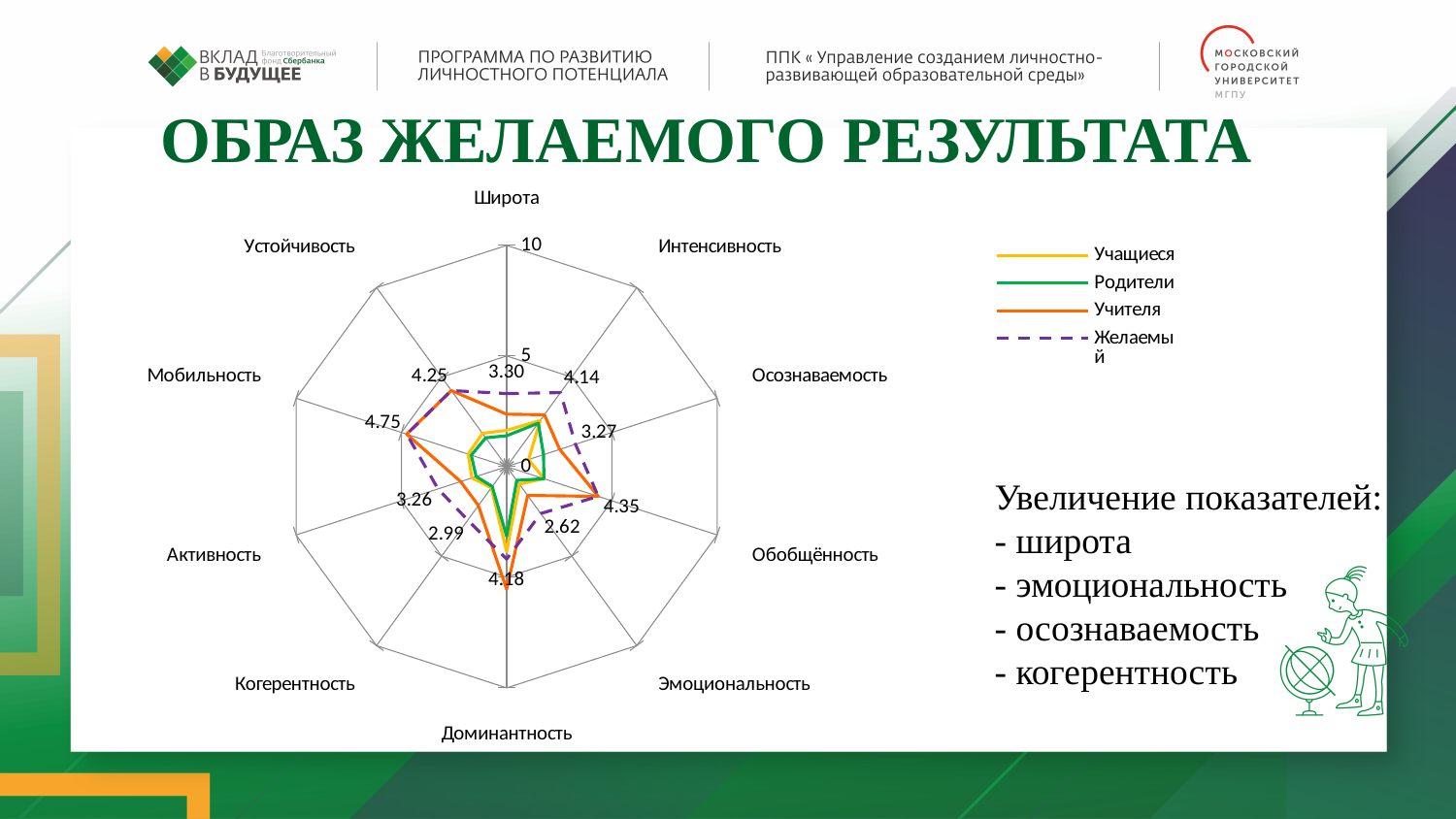
What kind of chart is shown on the slide? radar chart What value is labelled on the Широта axis of the chart? 3.30 Which labelled value is larger: Обобщённость or Осознаваемость? Обобщённость Which axis has the highest labelled value on the chart? Мобильность Which series in the legend is drawn with a dashed line? Желаемый What value is labelled on the Мобильность axis of the chart? 4.75 What value is labelled on the Эмоциональность axis of the chart? 2.62 What is the difference between the labelled values on the Мобильность and Эмоциональность axes? 2.13 Which axis has the lowest labelled value on the chart? Эмоциональность How many axes (categories) does the radar chart have? 10 How many series does the chart legend list? 4 What value is labelled on the Доминантность axis of the chart? 4.18